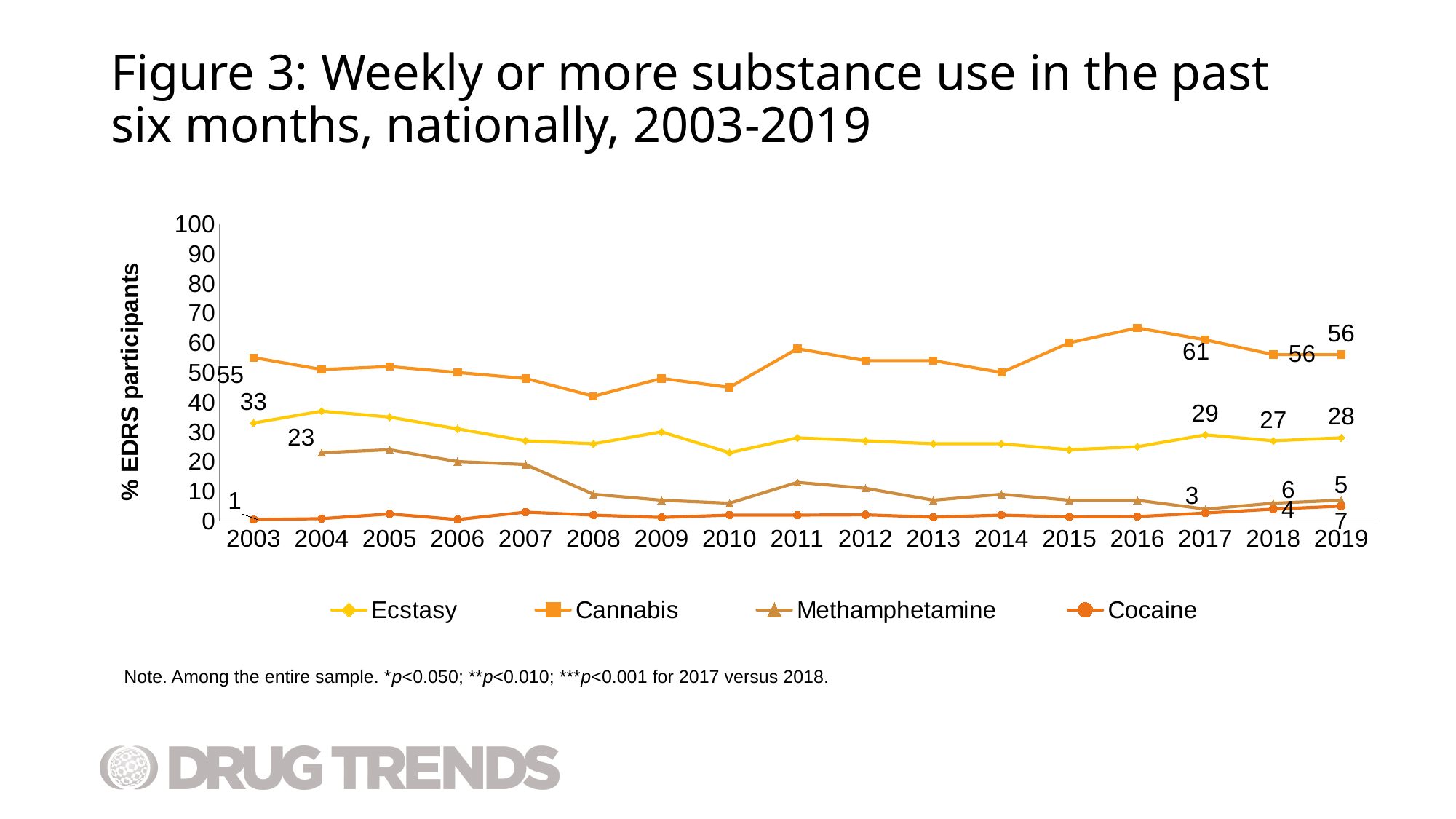
What was the value for Methamphetamine in 2004? 23 What was the value for Ecstasy in 2019? 28 What kind of chart is shown on the slide? line chart How many years are shown on the x axis? 17 Is the value for Cannabis in 2016 greater or less than 60? greater What was the value for Cannabis in 2003? 55 What was the percentage of EDRS participants reporting weekly or more cannabis use in 2017? 61 By how many percentage points did Cannabis fall from 2017 to 2018? 5 What was the value for Ecstasy in 2003? 33 Which year had the higher Ecstasy value, 2017 or 2018? 2017 Which substance had the highest value in 2019? Cannabis How many series does the legend list? 4